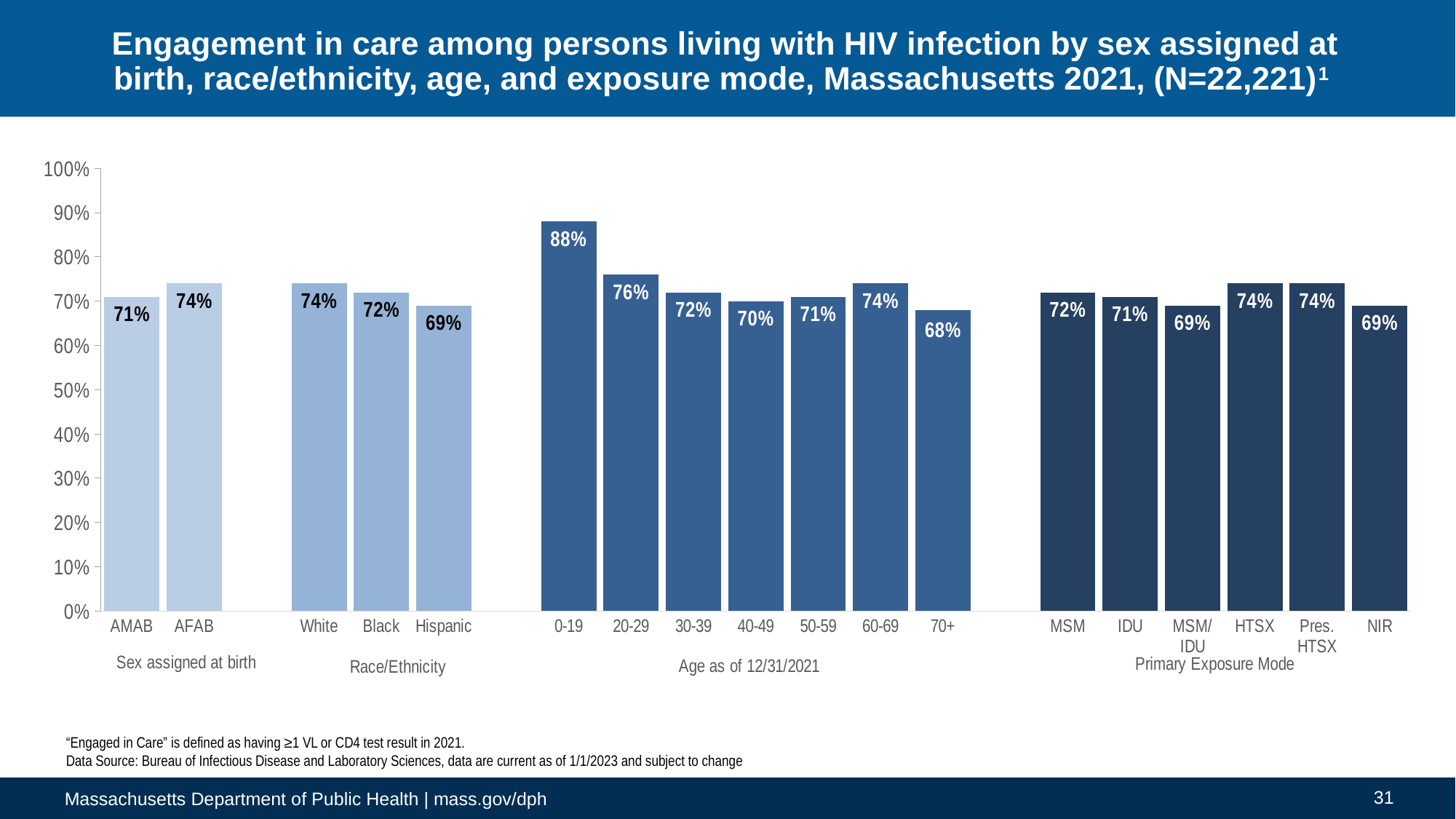
What is the engagement in care value for IDU? 71% Which has a higher engagement in care value, AMAB or AFAB? AFAB What is the difference between the engagement in care values for the 0-19 and 20-29 age groups? 12% What is the difference between the engagement in care values for White and Hispanic? 5% Which category has the highest engagement in care value on the chart? 0-19 Which age group has the lowest engagement in care value? 70+ What kind of chart is shown on the slide? Bar chart What is the engagement in care value for the 0-19 age group? 88% What is the engagement in care value for AFAB? 74% Is the value for the 0-19 age group greater or less than 80%? greater What is the engagement in care value for Hispanic? 69% How many bars are plotted in the Primary Exposure Mode group? 6